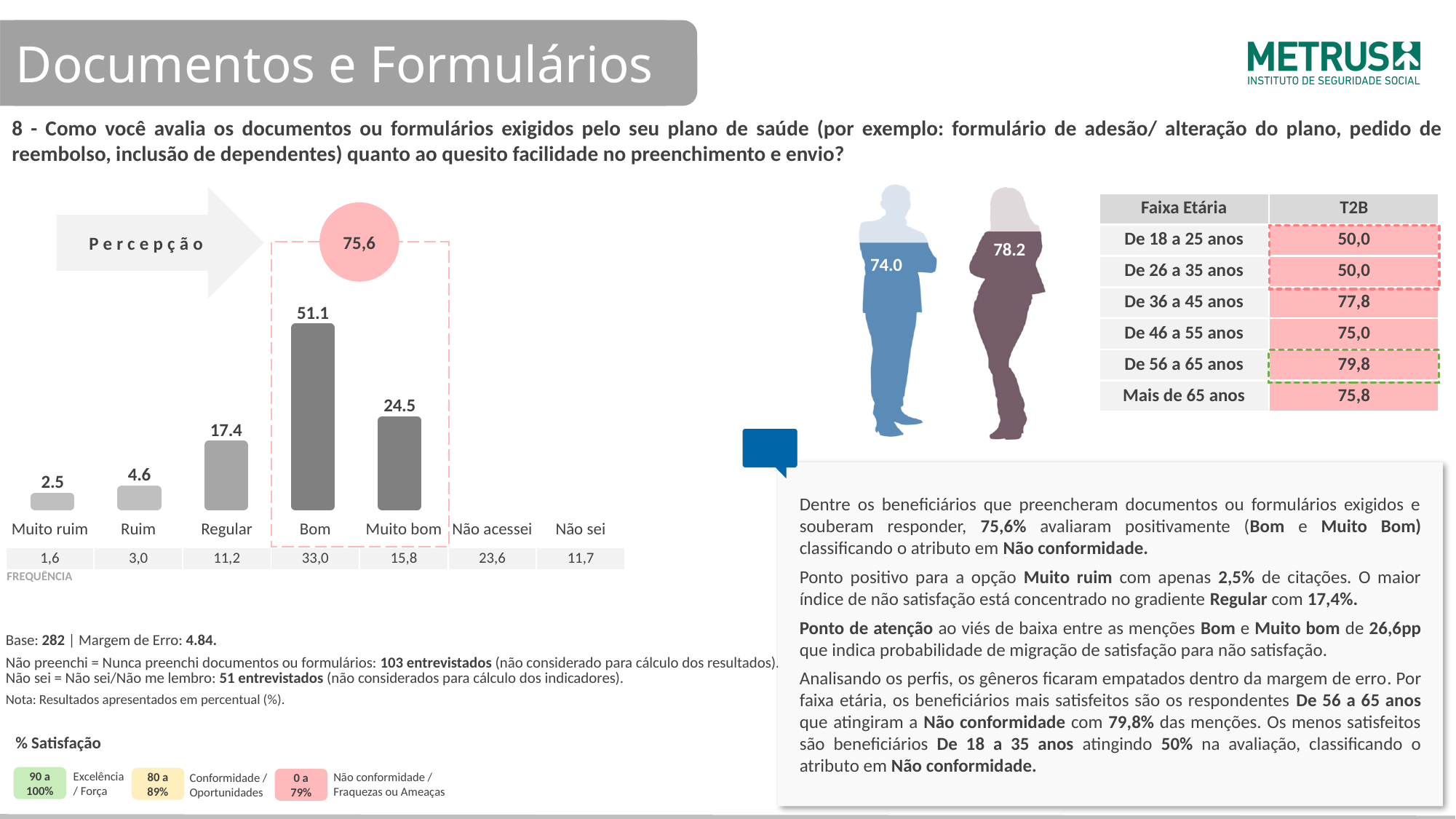
Which category has the highest bar in the chart? Bom Which category has the lowest bar in the chart? Muito ruim What is the value for Muito bom in the bar chart? 24.5 What is the value for Bom in the bar chart? 51.1 What is the difference between the values for Bom and Muito bom? 26.6 What is the frequency value shown below the Bom bar? 33,0 What is the value for Regular in the bar chart? 17.4 What is the value for Muito ruim in the bar chart? 2.5 What is the value for Ruim in the bar chart? 4.6 What is the combined value of Bom and Muito bom shown in the circle above the chart? 75,6 Which is larger, the value for Ruim or the value for Regular? Regular What kind of chart is shown on the left of the slide? bar chart